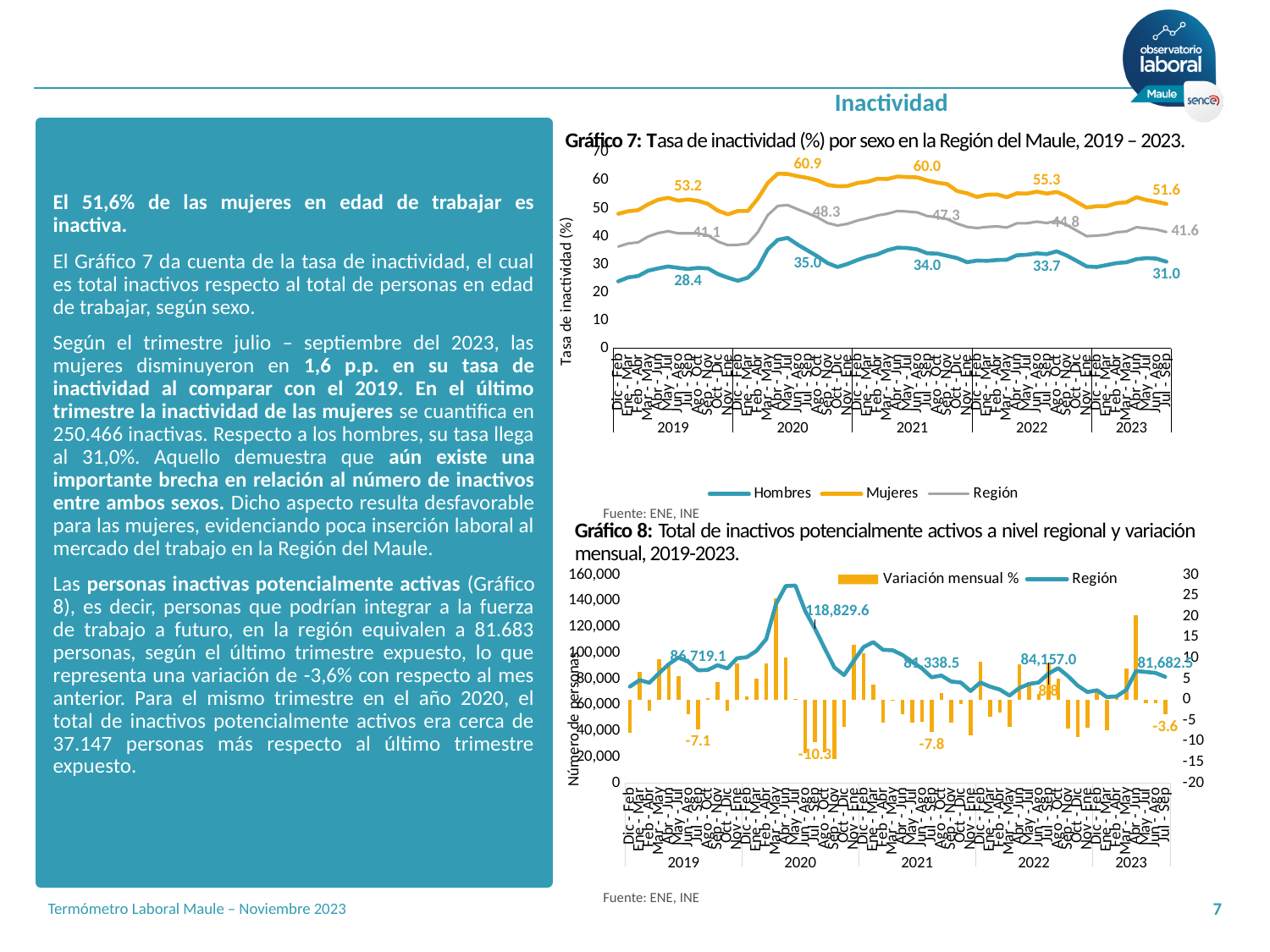
In Gráfico 8, what is the difference between the 2020 peak (118,829.6) and the last value (81,682.5) of the Región line? 37,147.1 In Gráfico 7, what is the labelled value for Región in 2023? 41.6 What kind of chart is Gráfico 7? Line chart In Gráfico 8, what is the last labelled value of the Región line (2023)? 81,682.5 In Gráfico 8, what is the peak labelled value of the Región line in 2020? 118,829.6 In Gráfico 7, what is the highest labelled value for the Mujeres series? 60.9 How many series does the legend of Gráfico 7 list? 3 In Gráfico 7, what is the difference between the last labelled values for Mujeres (51.6) and Hombres (31.0)? 20.6 In Gráfico 7, what is the first labelled inactivity rate for Hombres (2019)? 28.4 In Gráfico 8, what is the last labelled Variación mensual % value? -3.6 In Gráfico 7, which series has higher values throughout, Hombres or Mujeres? Mujeres In Gráfico 7, what is the last labelled inactivity rate for Mujeres (2023)? 51.6